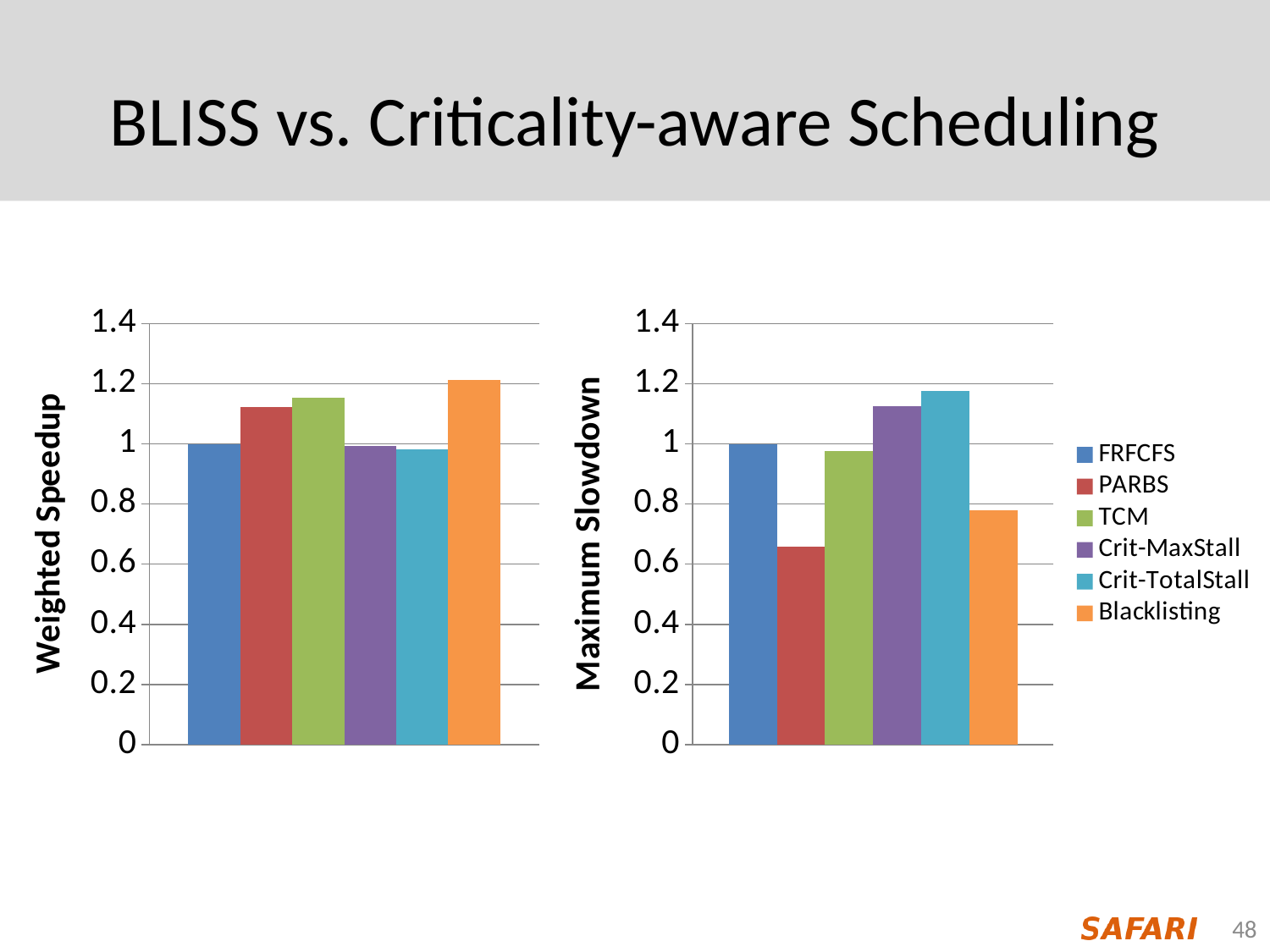
In the Maximum Slowdown chart on the right, which is larger, the value for Crit-MaxStall or the value for Blacklisting? Crit-MaxStall In the Maximum Slowdown chart on the right, is the value for Blacklisting greater or less than 1? less How many bars are plotted in the Maximum Slowdown chart on the right? 6 What is the y-axis label of the chart on the left? Weighted Speedup In the Maximum Slowdown chart on the right, which series has the highest value? Crit-TotalStall In the Weighted Speedup chart on the left, which series has the highest value? Blacklisting In the Weighted Speedup chart on the left, which is larger, the value for PARBS or the value for Crit-TotalStall? PARBS In the Maximum Slowdown chart on the right, which series has the lowest value? PARBS How many series does the legend list? 6 What kind of chart is the Weighted Speedup chart on the left? bar chart In the Maximum Slowdown chart on the right, is the value for PARBS greater or less than 0.8? less